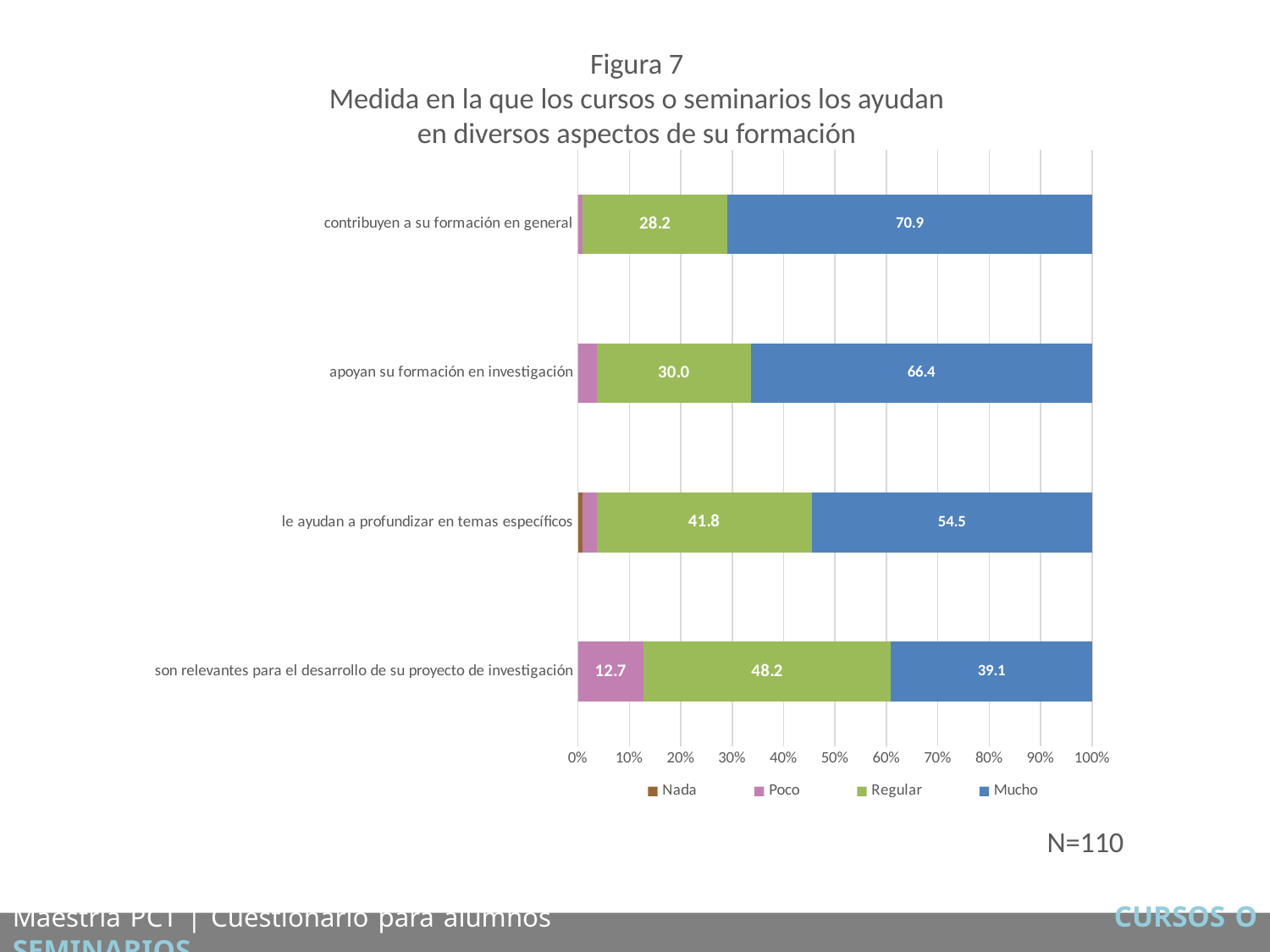
Is the 'Regular' value for 'le ayudan a profundizar en temas específicos' greater or less than 40%? greater Which is larger for 'son relevantes para el desarrollo de su proyecto de investigación': the 'Regular' value or the 'Mucho' value? Regular How many categories are plotted on the chart? 4 Which category has the lowest 'Mucho' value? son relevantes para el desarrollo de su proyecto de investigación What is the 'Poco' value for 'son relevantes para el desarrollo de su proyecto de investigación'? 12.7 How many series does the legend list? 4 What is the difference between the 'Mucho' values for 'contribuyen a su formación en general' and 'le ayudan a profundizar en temas específicos'? 16.4 What is the 'Mucho' value for 'contribuyen a su formación en general'? 70.9 What type of chart is shown on the slide? Stacked bar chart What is the 'Regular' value for 'apoyan su formación en investigación'? 30.0 Which category has the highest 'Mucho' value? contribuyen a su formación en general What is the sample size (N) shown on the slide? N=110